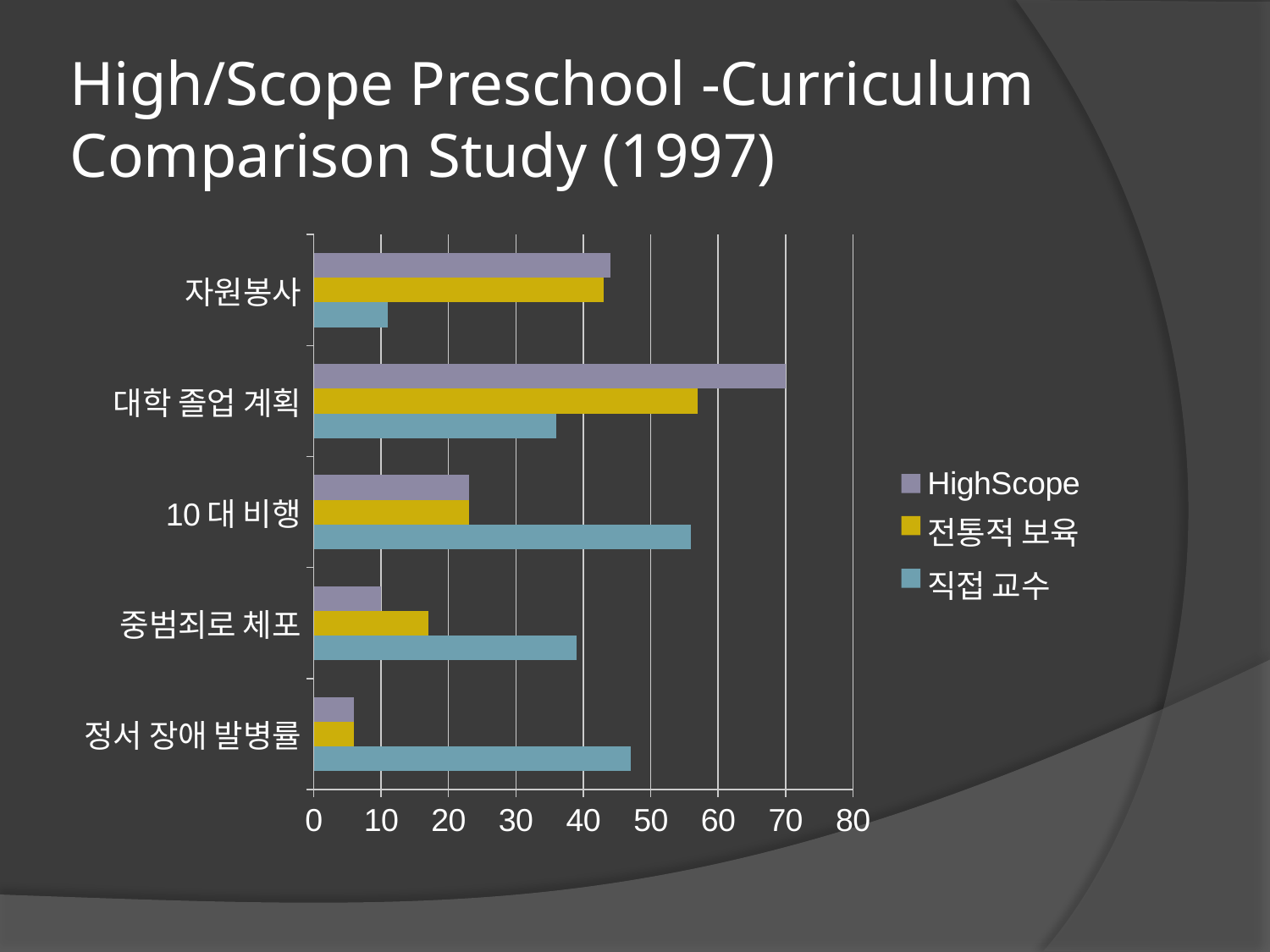
Is the HighScope value for 자원봉사 greater or less than 40? greater Is the HighScope value for 정서 장애 발병률 greater or less than 10? less For 10 대 비행, which is larger: the HighScope value or the 직접 교수 value? 직접 교수 How many series does the chart's legend list? 3 Which category has the lowest HighScope value? 정서 장애 발병률 For 자원봉사, which is larger: the HighScope value or the 직접 교수 value? HighScope What kind of chart is shown on the slide? bar chart Which category has the highest 직접 교수 value? 10 대 비행 Which category has the highest HighScope value? 대학 졸업 계획 What are the three series listed in the legend? HighScope, 전통적 보육, 직접 교수 How many categories are shown on the chart? 5 Is the 직접 교수 value for 정서 장애 발병률 greater or less than 40? greater